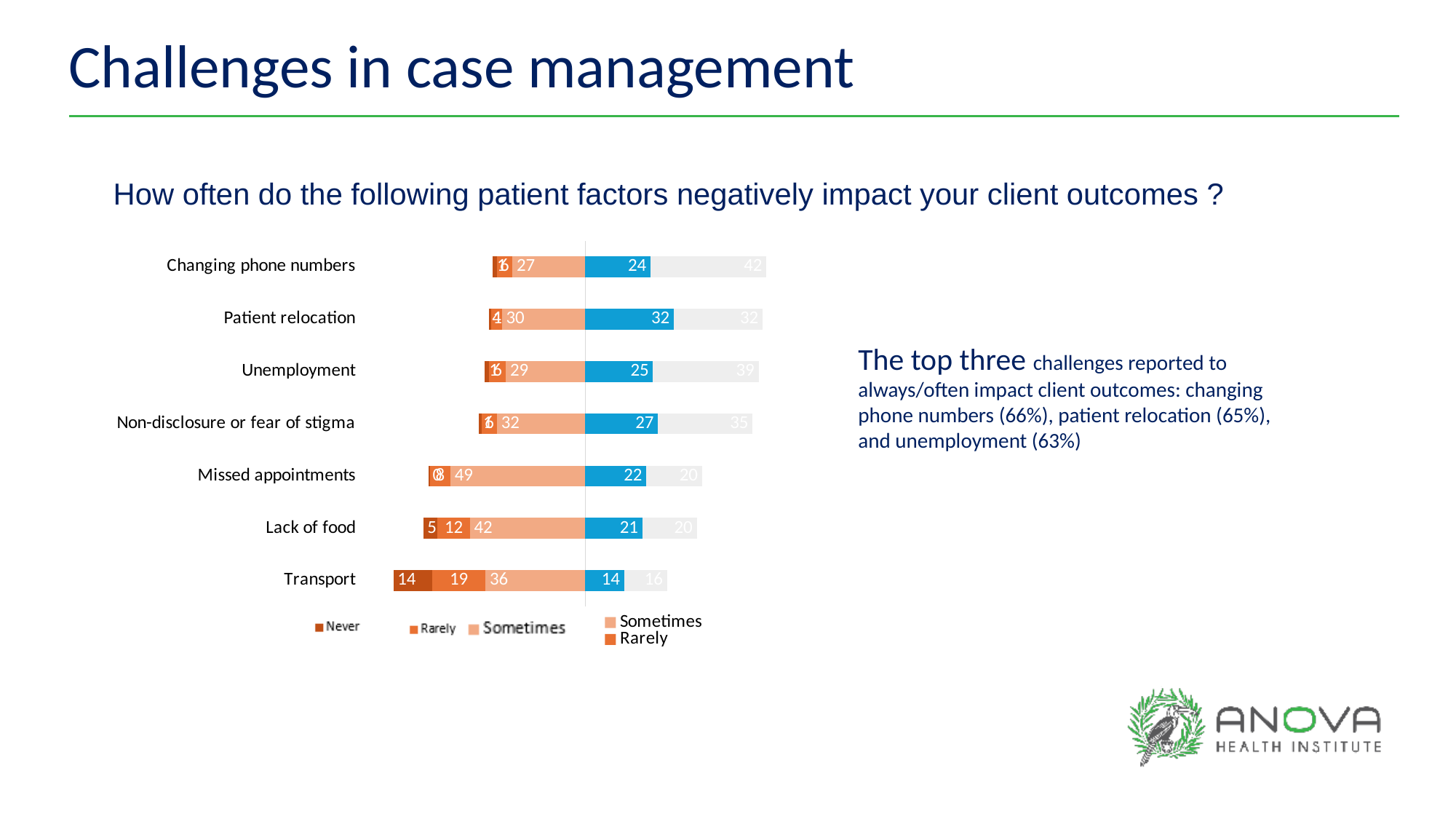
What is the difference between the 'Sometimes' values for Missed appointments and Lack of food? 7 What is the 'Sometimes' value for Patient relocation? 30 What is the 'Sometimes' value for Missed appointments? 49 What kind of chart is shown on the slide? bar chart What is the 'Never' value for Transport? 14 What is the 'Never' value for Lack of food? 5 Which has the larger 'Sometimes' value, Transport or Patient relocation? Transport What question is the chart answering, as stated above it? How often do the following patient factors negatively impact your client outcomes ? Which patient factor has the highest 'Sometimes' value? Missed appointments What is the 'Rarely' value for Transport? 19 Which patient factor has the lowest 'Sometimes' value? Changing phone numbers How many patient factors (categories) are listed on the chart? 7